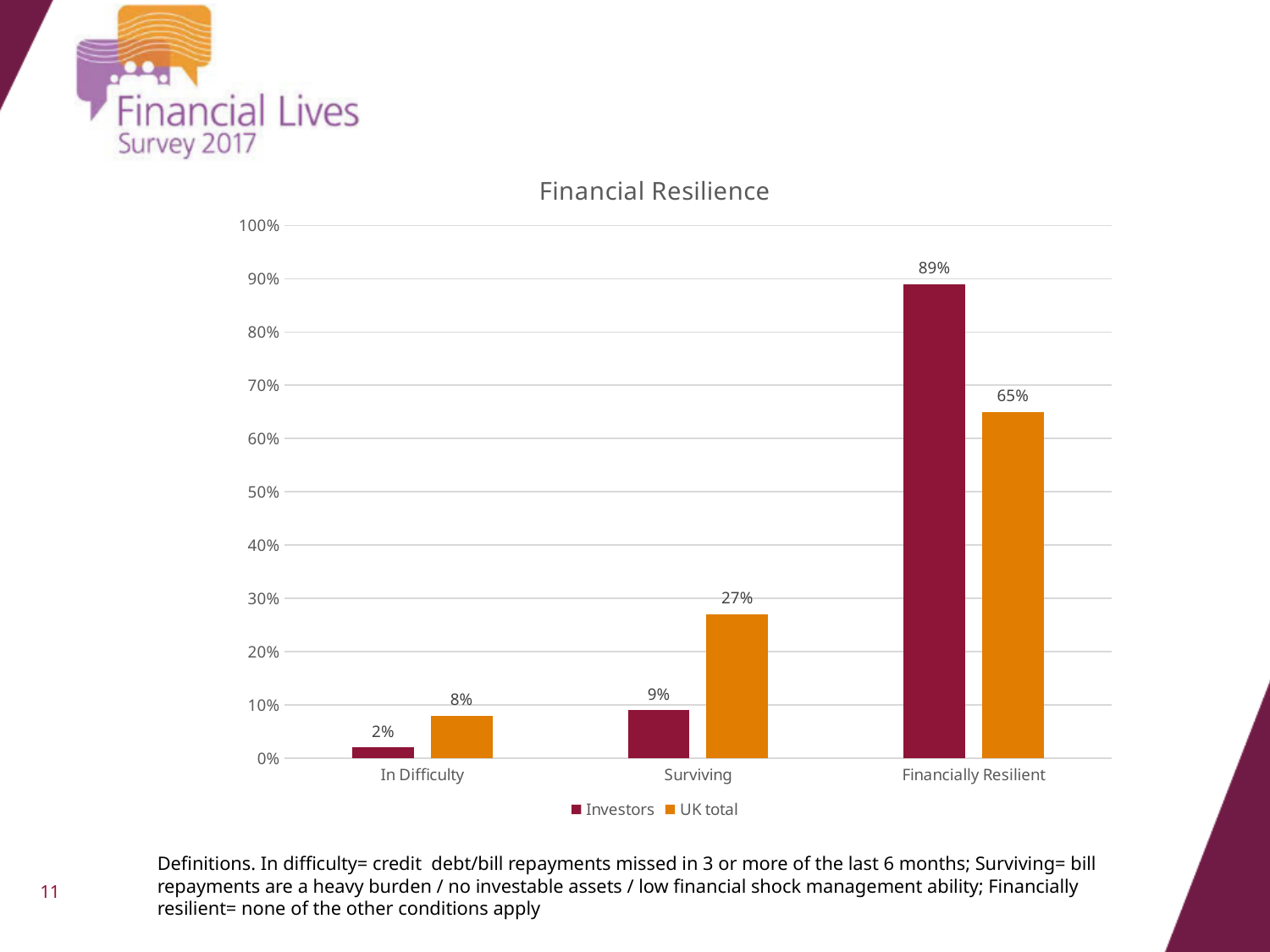
What is the title of the chart? Financial Resilience What is the value for Investors in the Financially Resilient category? 89% What is the value for Investors in the In Difficulty category? 2% Which is larger in the Surviving category, Investors or UK total? UK total How many series does the legend list? 2 What is the value for UK total in the Surviving category? 27% What is the value for UK total in the In Difficulty category? 8% How many categories are shown on the x axis? 3 What kind of chart is shown on the slide? Bar chart Which category has the highest value for the Investors series? Financially Resilient What is the difference between the Investors and UK total values in the Financially Resilient category? 24% Which category has the lowest value for the UK total series? In Difficulty